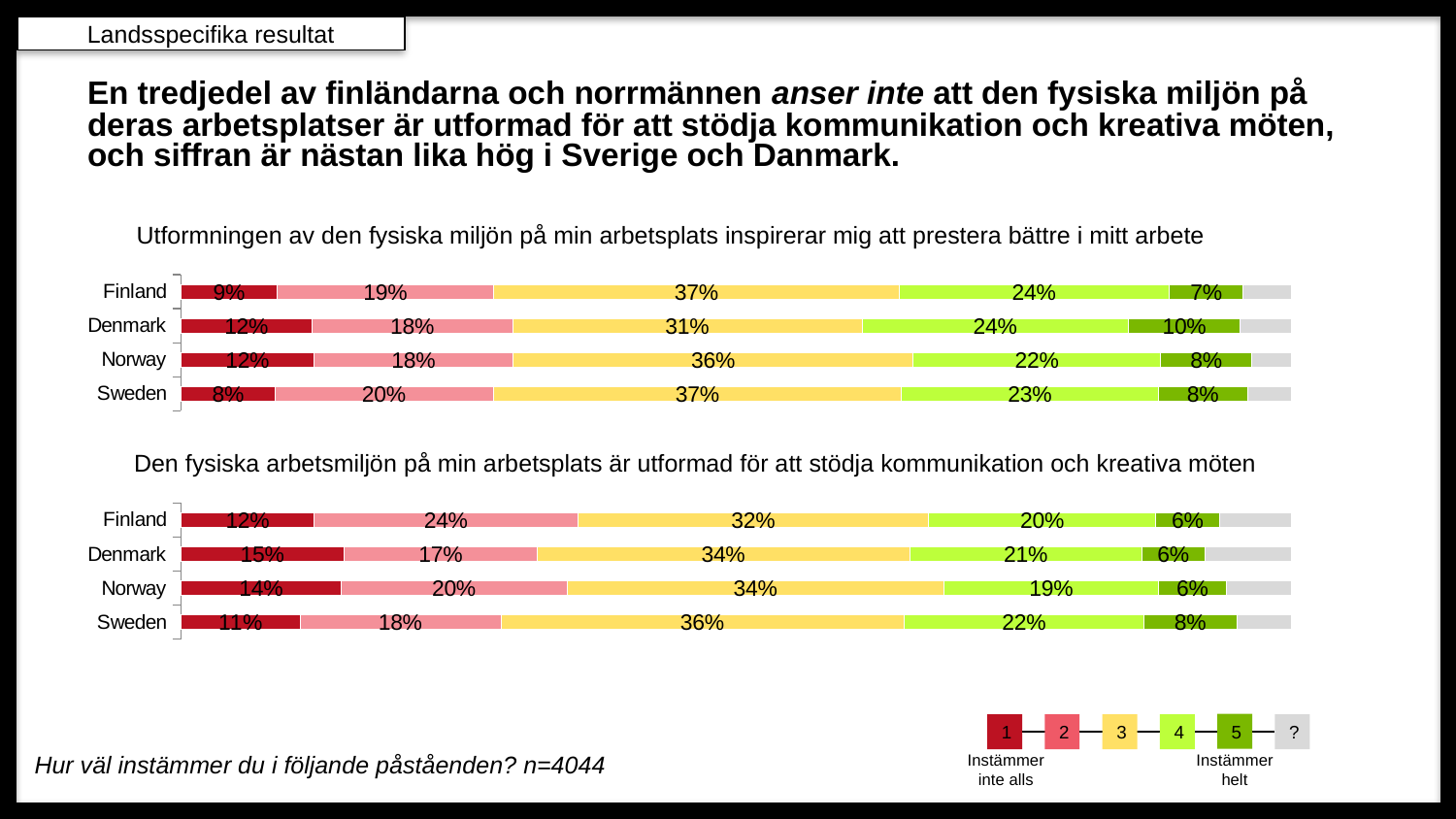
In the bottom chart, what is the combined share of Finland respondents answering 1 or 2? 36% In the top chart, which is larger: Denmark's share answering 3 or Norway's share answering 3? Norway In the top chart, which country has the highest share answering 5? Denmark In the top chart, what percentage of respondents in Denmark answered 5 (Instämmer helt)? 10% In the bottom chart, what is the difference between Finland's and Denmark's share answering 2? 7 percentage points What type of chart is used on this slide? Stacked bar chart How many response categories does the legend at the bottom of the slide list? 6 In the bottom chart ("Den fysiska arbetsmiljön..."), what percentage of respondents in Denmark answered 1 (Instämmer inte alls)? 15% In the top chart ("Utformningen av den fysiska miljön..."), what percentage of respondents in Finland answered 3? 37% How many countries are shown in each chart? 4 In the bottom chart, which country has the lowest share answering 1? Sweden In the bottom chart, what percentage of respondents in Sweden answered 3? 36%